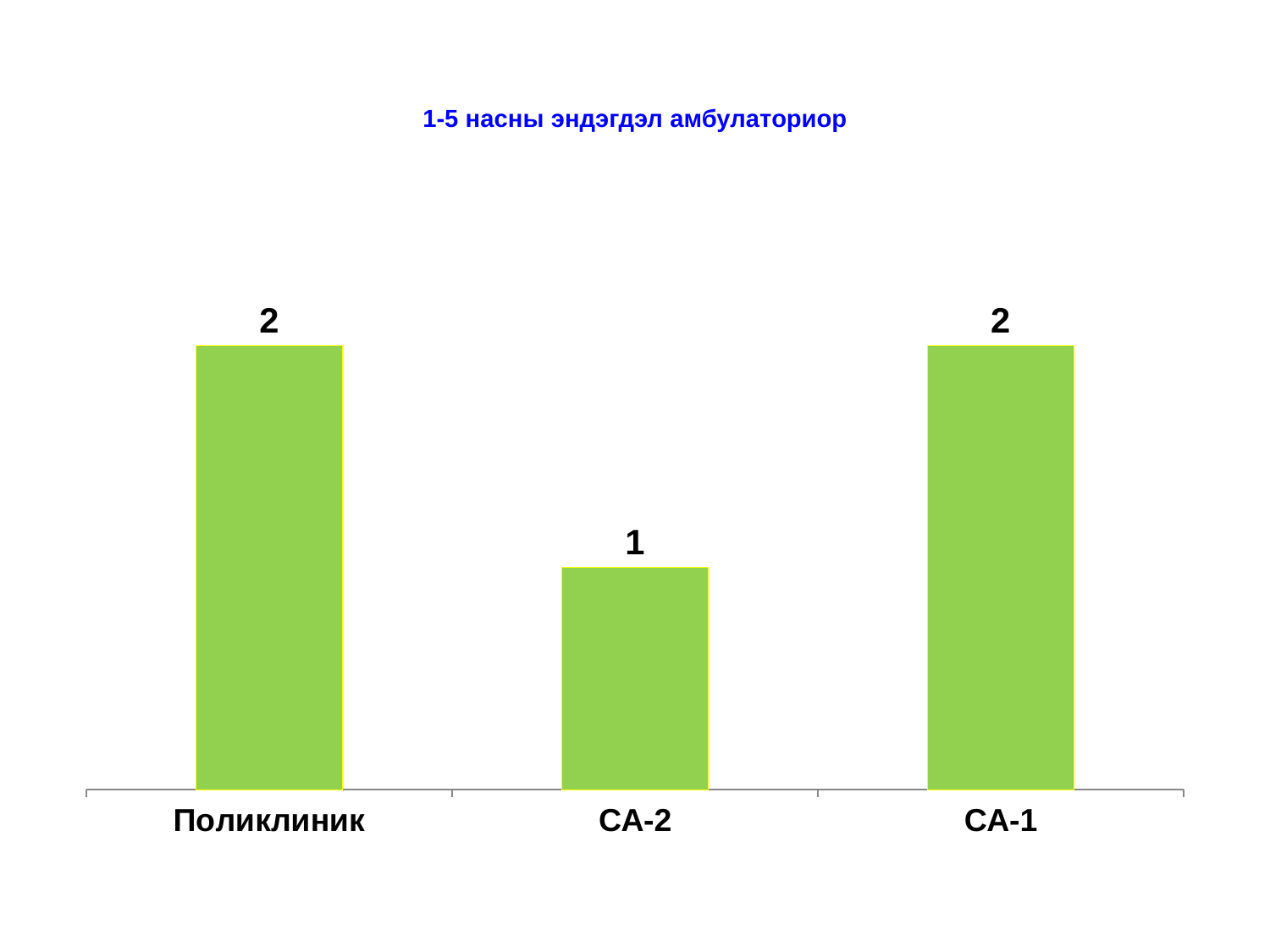
What is the value for Поликлиник? 2 What kind of chart is shown on the slide? bar chart Which category has the lowest value? СА-2 What is the title of the chart? 1-5 насны эндэгдэл амбулаториор How many categories are shown on the chart? 3 What is the difference between the values for Поликлиник and СА-2? 1 What is the value for СА-1? 2 Which is larger, the value for СА-1 or the value for СА-2? СА-1 Do the values for Поликлиник and СА-1 differ? No, both are 2 What is the value for СА-2? 1 What colour are the bars in the chart? green